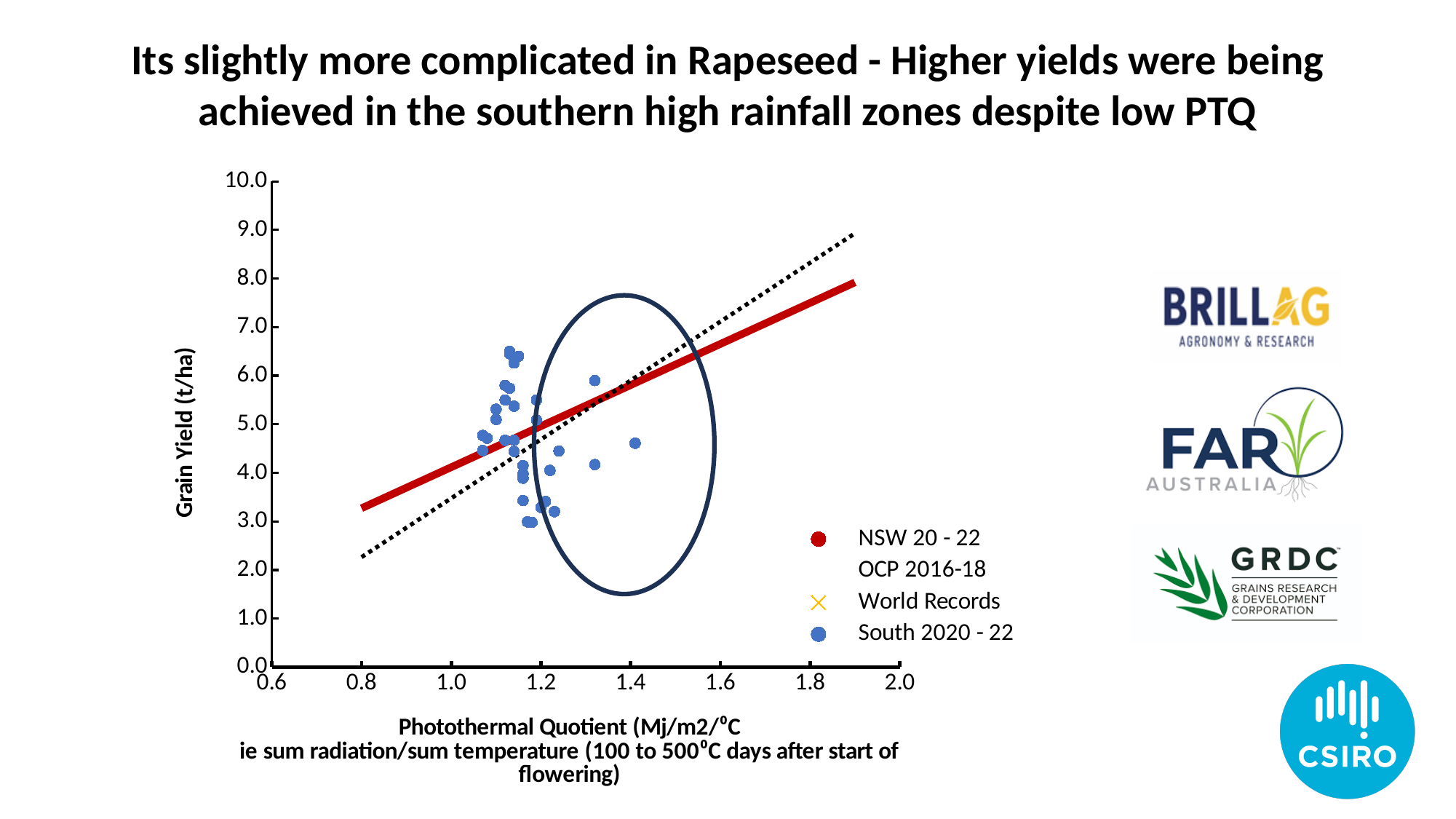
How many series does the legend list? 4 Is the highest South 2020 - 22 point greater or less than 7.0 t/ha? less Is the value of the dotted black line at a Photothermal Quotient of 0.8 greater or less than 3.0? less Which legend entry is shown with a red marker? NSW 20 - 22 Is the value of the dotted black line at a Photothermal Quotient of 1.8 greater or less than 8.0? greater Does the solid red line rise or fall as the Photothermal Quotient increases? rise Does the dotted black line rise or fall as the Photothermal Quotient increases? rise What is the minimum value shown on the x axis? 0.6 What is the label of the y axis? Grain Yield (t/ha) What is the maximum value shown on the y axis? 10.0 What kind of chart is shown on the slide? scatter chart